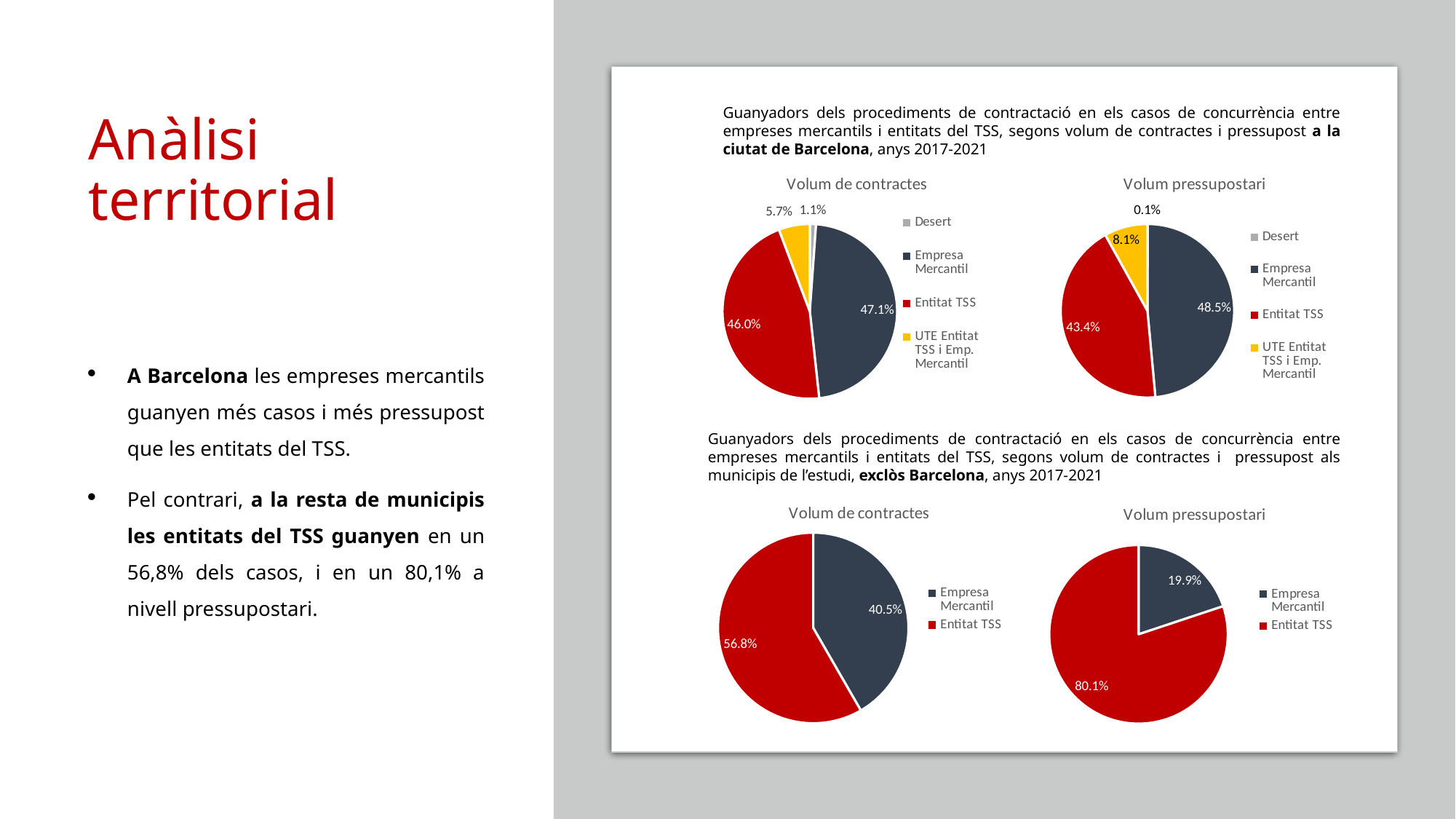
In the top-left pie chart (Barcelona, Volum de contractes), which is larger: Empresa Mercantil or UTE Entitat TSS i Emp. Mercantil? Empresa Mercantil In the top-left pie chart (Barcelona, Volum de contractes), what share does Empresa Mercantil have? 47.1% In the bottom-left pie chart (exclòs Barcelona, Volum de contractes), what share does Entitat TSS have? 56.8% In the top-left pie chart (Barcelona, Volum de contractes), what share does Entitat TSS have? 46.0% In the top-right pie chart (Barcelona, Volum pressupostari), which category has the smallest share? Desert In the top-right pie chart (Barcelona, Volum pressupostari), which category has the largest share? Empresa Mercantil In the top-right pie chart (Barcelona, Volum pressupostari), what share does UTE Entitat TSS i Emp. Mercantil have? 8.1% How many categories does the legend of the top-left pie chart (Barcelona, Volum de contractes) list? 4 What type of chart is used for the bottom-right chart (exclòs Barcelona, Volum pressupostari)? Pie chart In the bottom-right pie chart (exclòs Barcelona, Volum pressupostari), what share does Empresa Mercantil have? 19.9% How many categories does the legend of the bottom-left pie chart (exclòs Barcelona, Volum de contractes) list? 2 In the bottom-right pie chart (exclòs Barcelona, Volum pressupostari), what is the difference between the Entitat TSS share and the Empresa Mercantil share? 60.2%